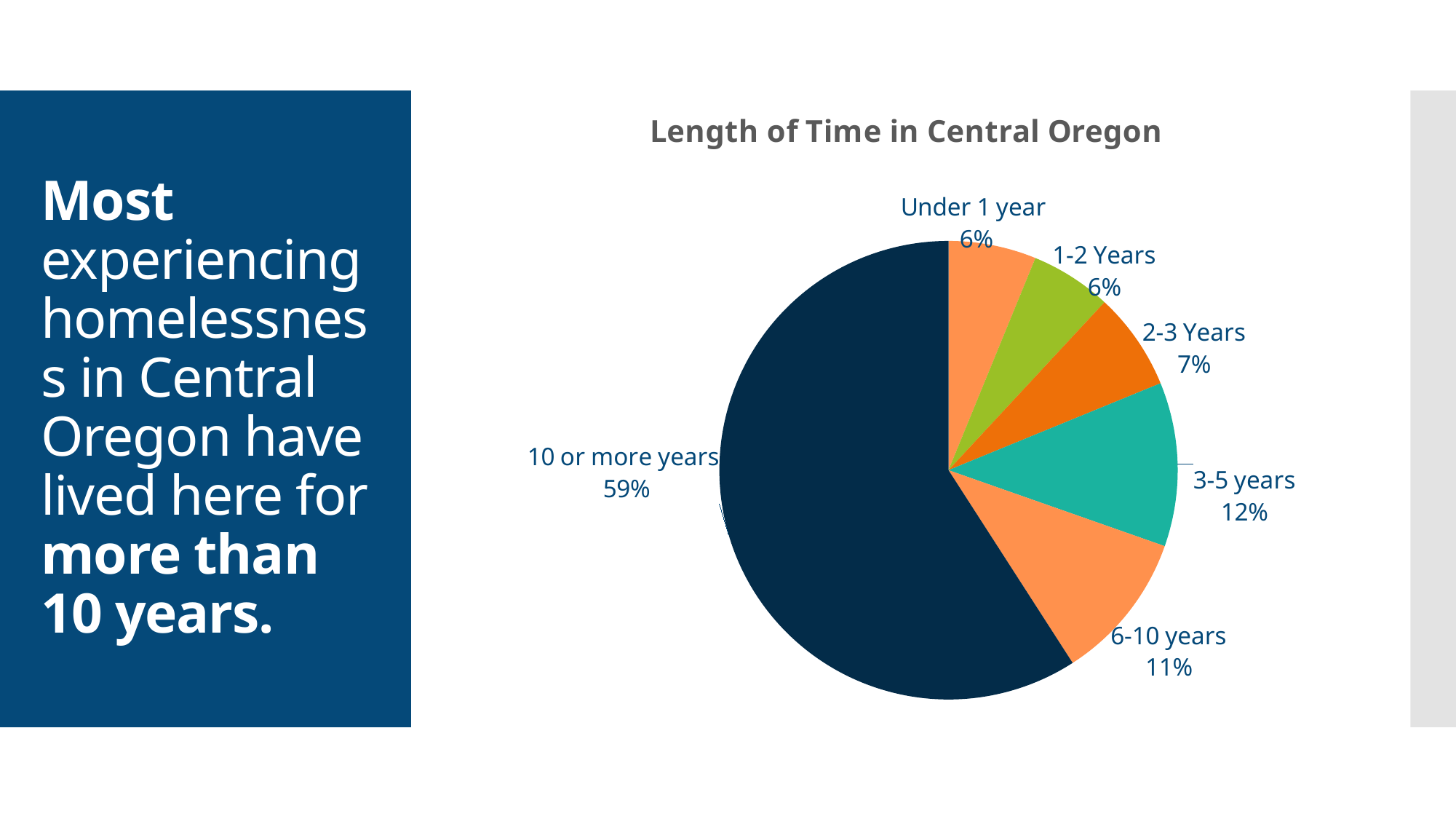
What share of the pie is labelled "10 or more years"? 59% What is the value shown for "2-3 Years"? 7% What is the difference between the values for "6-10 years" and "1-2 Years"? 5% What is the value shown for "6-10 years"? 11% Which is larger, the value for "3-5 years" or the value for "2-3 Years"? 3-5 years How many slices does the pie chart have? 6 What type of chart is shown on the slide? pie chart What is the value shown for "Under 1 year"? 6% What is the title of the chart? Length of Time in Central Oregon What is the difference between the values for "10 or more years" and "3-5 years"? 47% Which category has the largest slice of the pie? 10 or more years What is the value shown for "3-5 years"? 12%